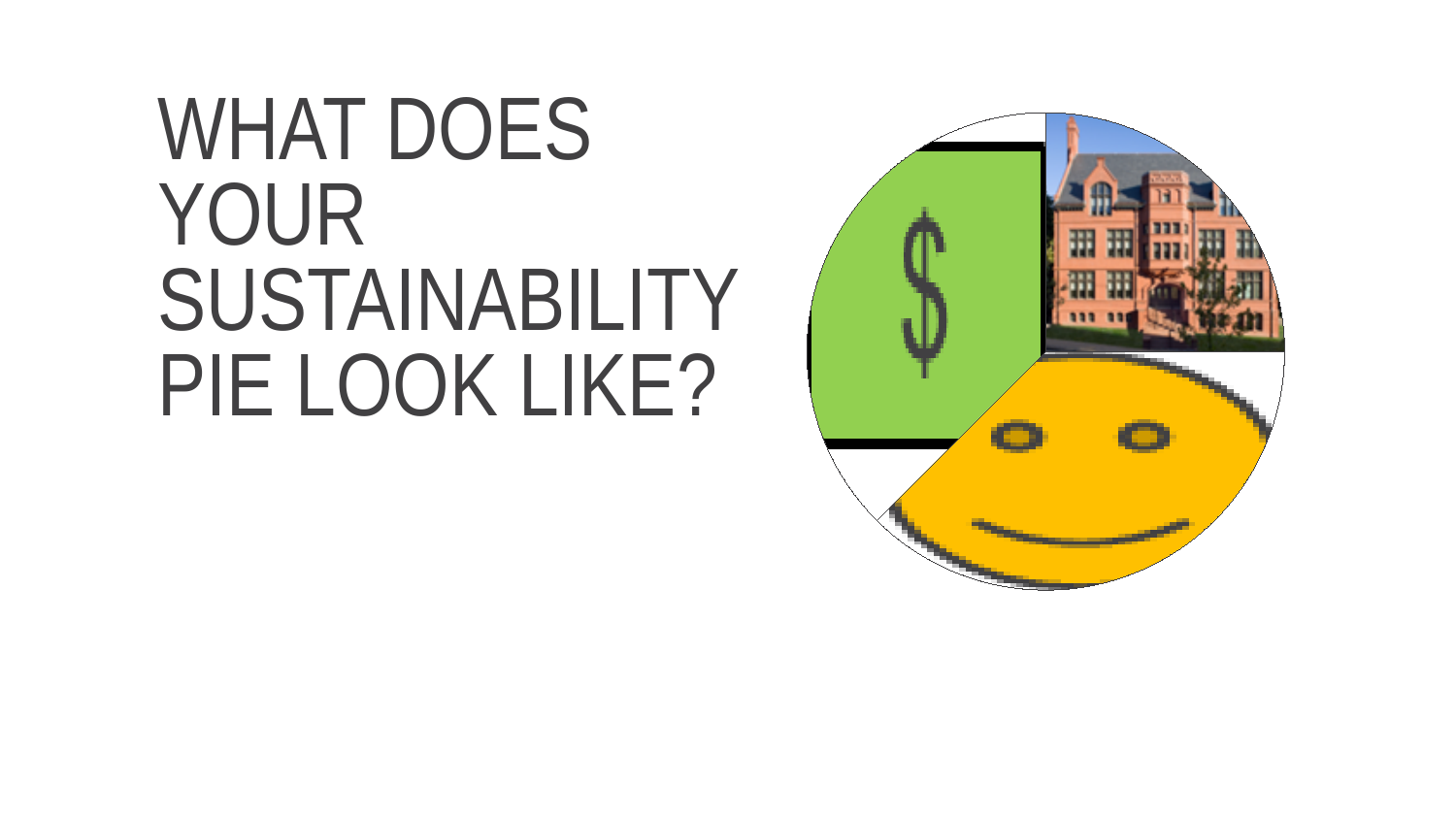
Which slice is larger in the pie chart, the dollar sign slice or the building slice? the dollar sign slice What kind of chart is shown on the slide? pie chart What is the title text on the slide next to the pie chart? WHAT DOES YOUR SUSTAINABILITY PIE LOOK LIKE? What colour is the slice containing the dollar sign? green How many slices does the pie chart have? 3 Which slice of the pie chart is the smallest: the dollar sign, the building, or the smiley face? the building